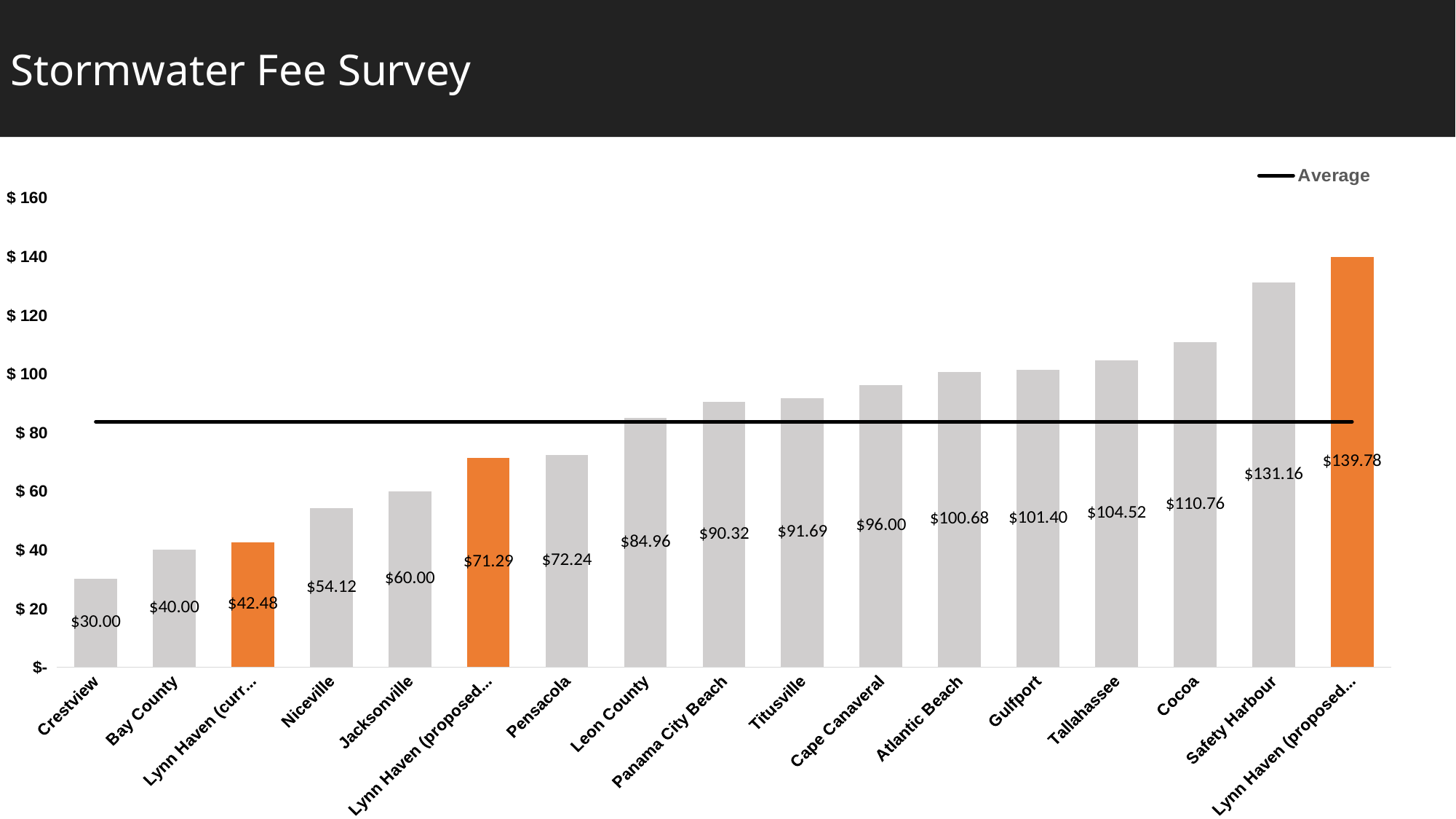
What is the highest value shown on the chart? $139.78 What is the value shown for Panama City Beach? $90.32 What is the stormwater fee shown for Crestview? $30.00 Which is larger, the value for Pensacola or the value for Leon County? Leon County Is the Average line greater or less than $100? less Which category has the lowest value? Crestview What kind of chart is shown on the slide? bar chart How many bars are shown on the chart? 17 What is the difference between the values for Jacksonville and Crestview? $30.00 Do the bar values rise or fall from left to right along the x axis? rise What is the difference between the values for Safety Harbour and Cocoa? $20.40 What is the value shown for Tallahassee? $104.52